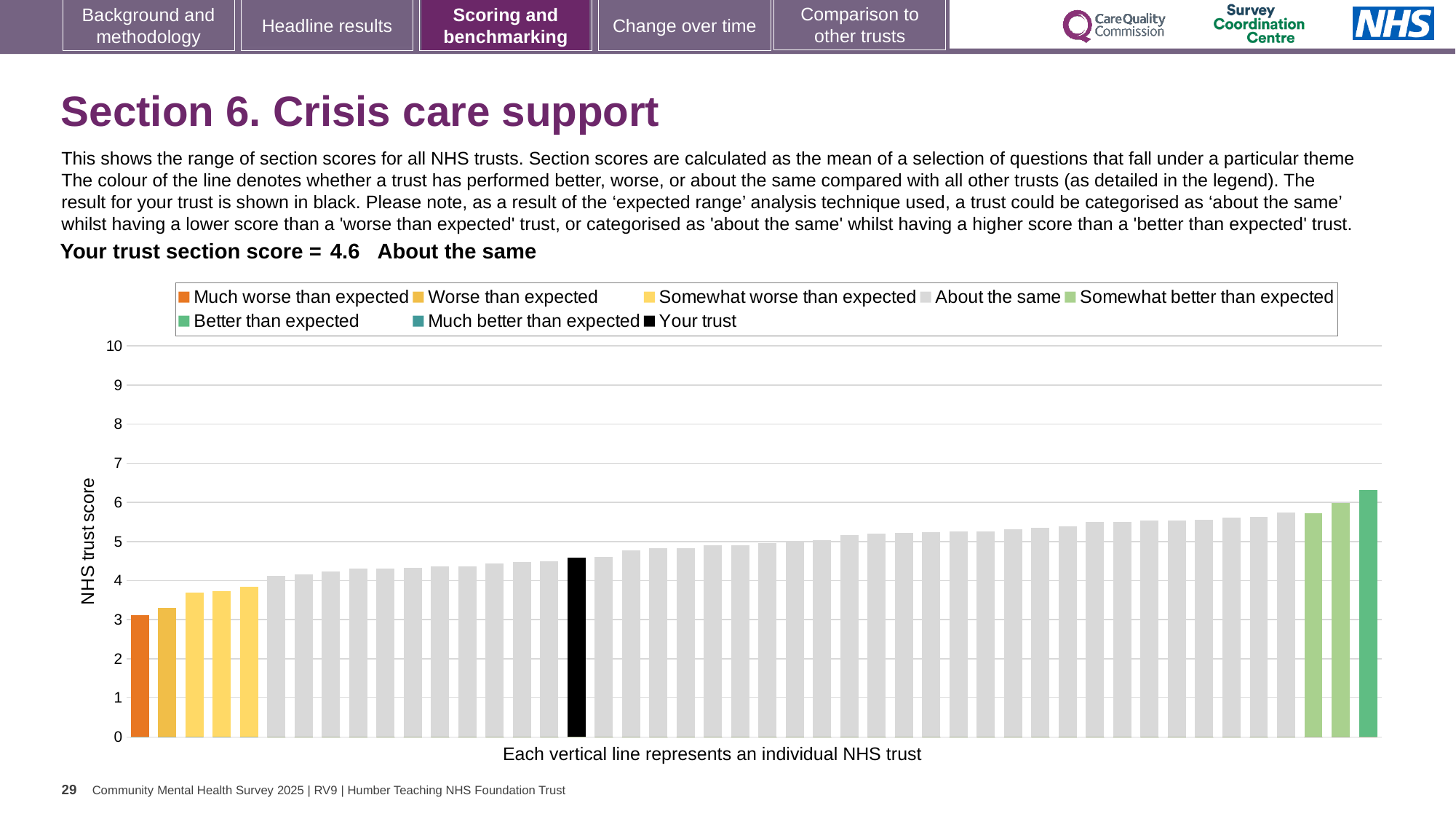
What kind of chart is shown on the slide? bar chart Is the value of the tallest bar greater or less than 6? greater What is the section score for your trust shown on the slide? 4.6 Which legend category does the shortest bar belong to? Much worse than expected How many bars are coloured as 'Somewhat better than expected'? 2 What is the label on the vertical axis of the chart? NHS trust score Is the value for your trust (the black bar) greater or less than 4? greater Which legend category does the tallest bar belong to? Better than expected Is the value of the shortest bar (the orange bar) greater or less than 4? less Do the bar values rise or fall from left to right along the x axis? rise Which is higher: the black 'Your trust' bar or the orange 'Much worse than expected' bar? Your trust How many entries does the chart legend list? 8